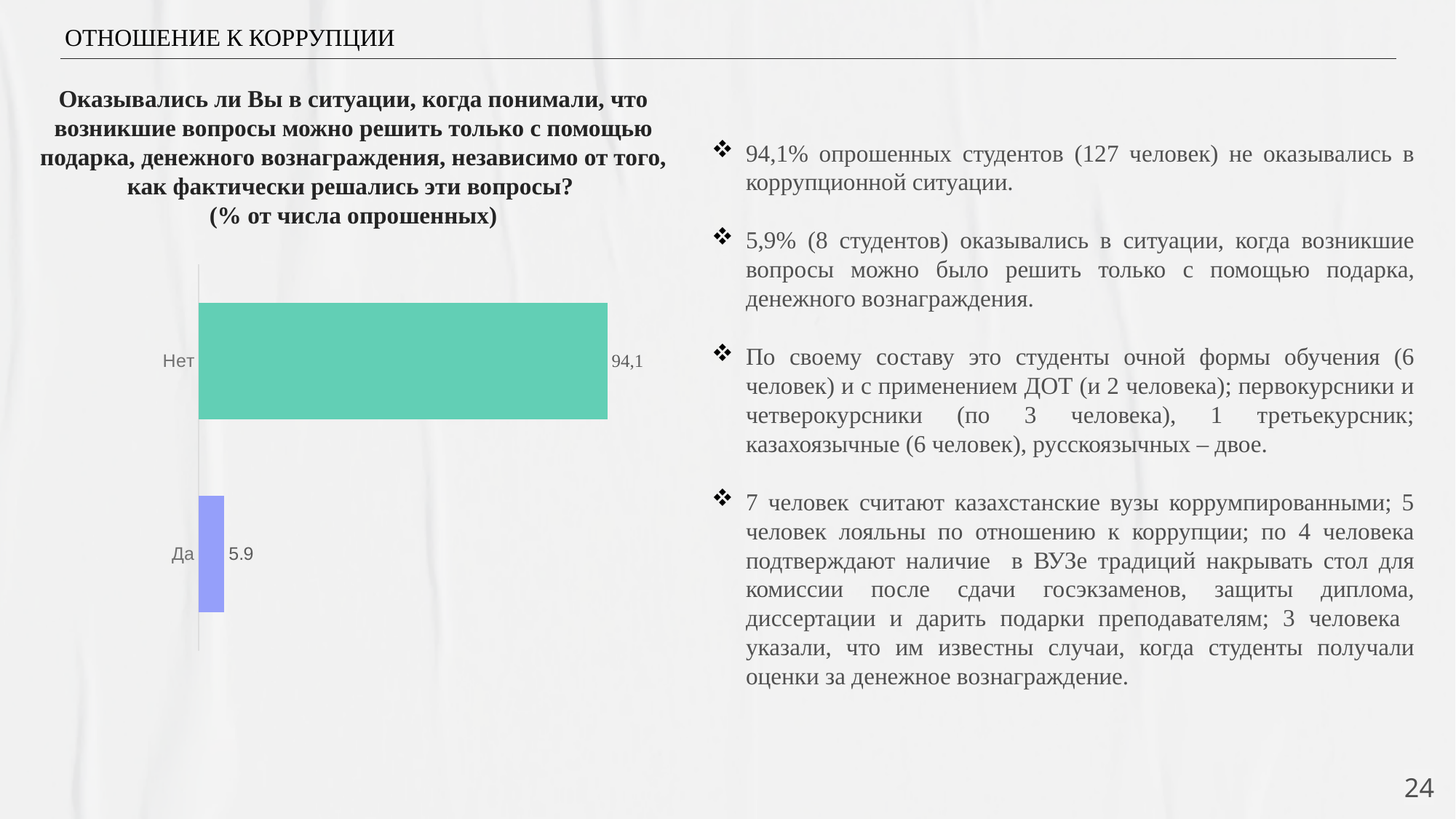
What unit does the chart title say the values are expressed in? % от числа опрошенных Which category has the highest value in the bar chart? Нет What is the value for "Да" in the bar chart? 5.9 What is the difference between the values for "Нет" and "Да" in the bar chart? 88,2 What colour is the bar for "Нет" in the chart? Green (teal) What kind of chart is shown on the slide? Bar chart Which category has the lowest value in the bar chart? Да What is the value for "Нет" in the bar chart? 94,1 How many categories are shown in the bar chart? 2 Which is larger in the bar chart, the value for "Нет" or the value for "Да"? Нет